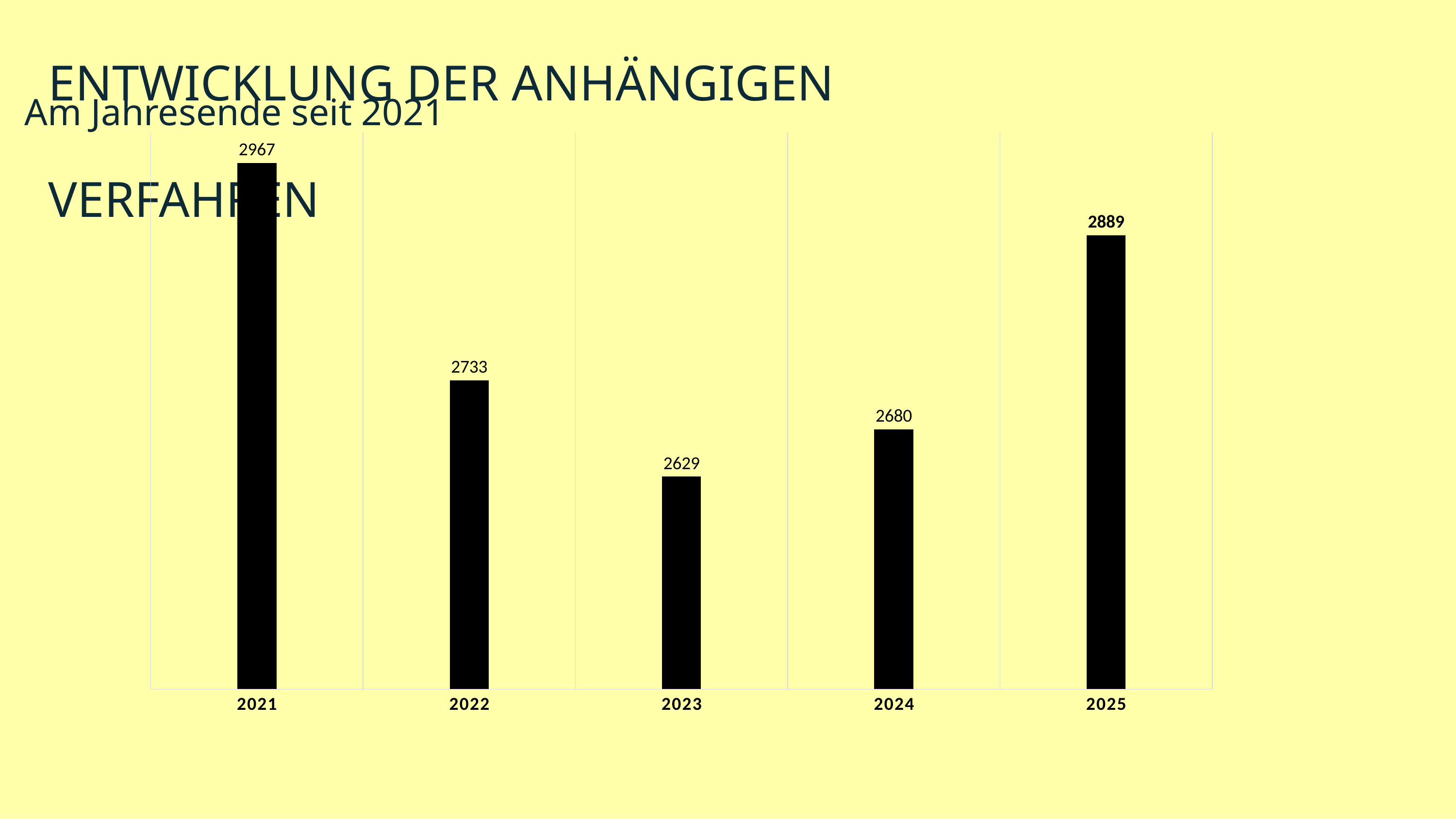
What is the subtitle text shown above the chart? Am Jahresende seit 2021 What is the value for 2025? 2889 Which is larger, the value for 2022 or the value for 2024? 2022 How many years are shown on the x axis? 5 What is the value for 2021? 2967 Which year has the lowest value? 2023 What kind of chart is shown on the slide? bar chart What is the value for 2023? 2629 Do the values rise or fall from 2021 to 2023? fall Which year has the highest value? 2021 What is the difference between the values for 2021 and 2022? 234 What is the difference between the values for 2025 and 2024? 209